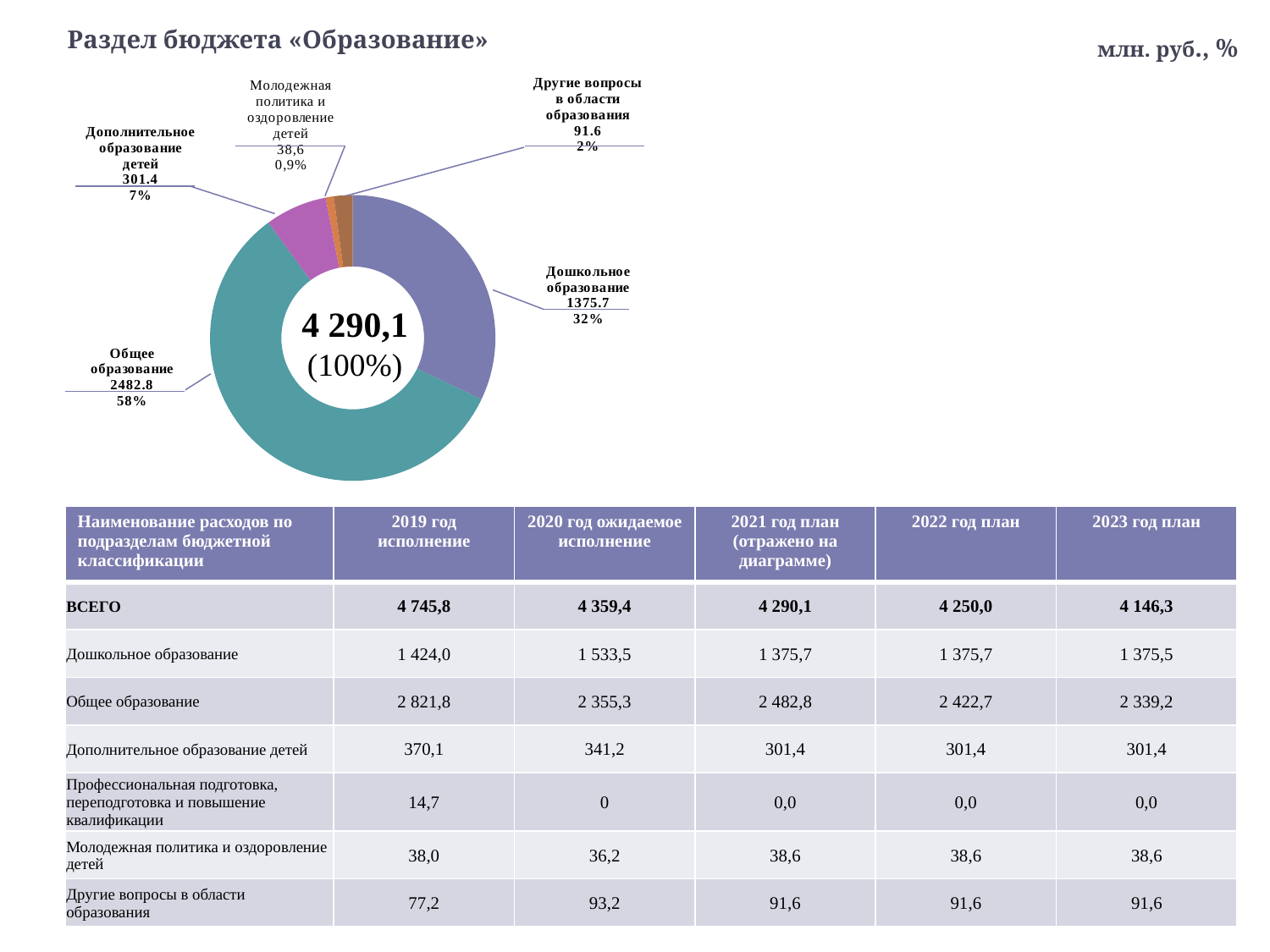
What is the value shown for Общее образование on the chart? 2482.8 What share of the chart does Дошкольное образование represent? 32% What share of the chart does Молодежная политика и оздоровление детей represent? 0,9% Which category has the smallest slice in the chart? Молодежная политика и оздоровление детей What is the value shown for Дополнительное образование детей on the chart? 301.4 What is the difference between the values for Общее образование and Дошкольное образование on the chart? 1107.1 Which is larger on the chart: Дошкольное образование or Дополнительное образование детей? Дошкольное образование Which category has the largest slice in the chart? Общее образование How many slices does the chart have? 5 What total value is shown in the centre of the chart? 4 290,1 What is the value shown for Другие вопросы в области образования on the chart? 91.6 What type of chart is shown on the slide? Pie (donut) chart